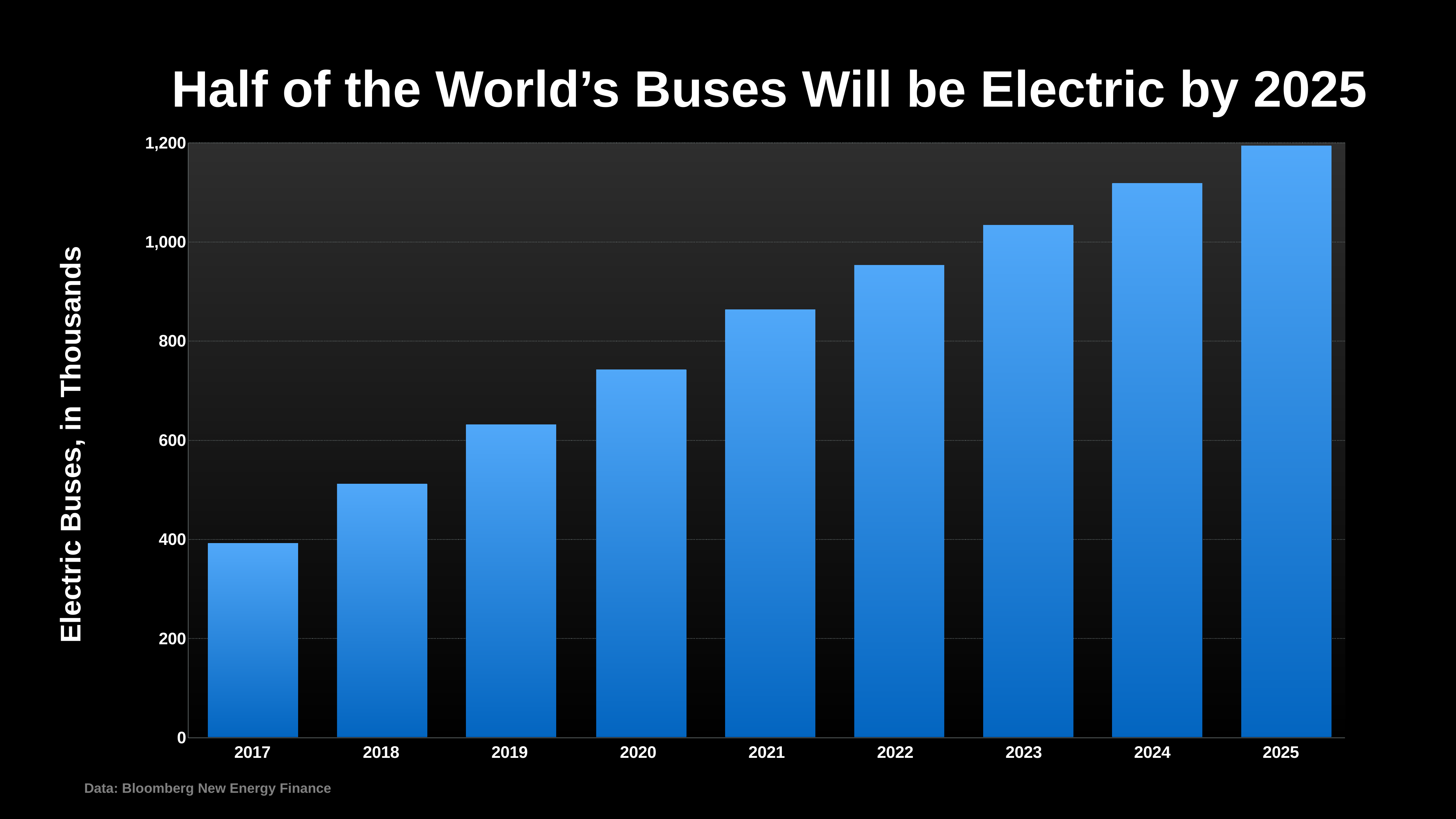
What is the label on the vertical axis? Electric Buses, in Thousands Which year has the lowest value? 2017 Which year has the highest value? 2025 How many years are shown on the x axis? 9 Do the values rise or fall from 2017 to 2025? rise Is the value for 2024 greater or less than 1,000? greater Which is larger, the value for 2019 or the value for 2023? 2023 Is the value for 2021 greater or less than 800? greater What kind of chart is shown on the slide? bar chart Is the value for 2018 greater or less than 600? less What is the title of the chart? Half of the World's Buses Will be Electric by 2025